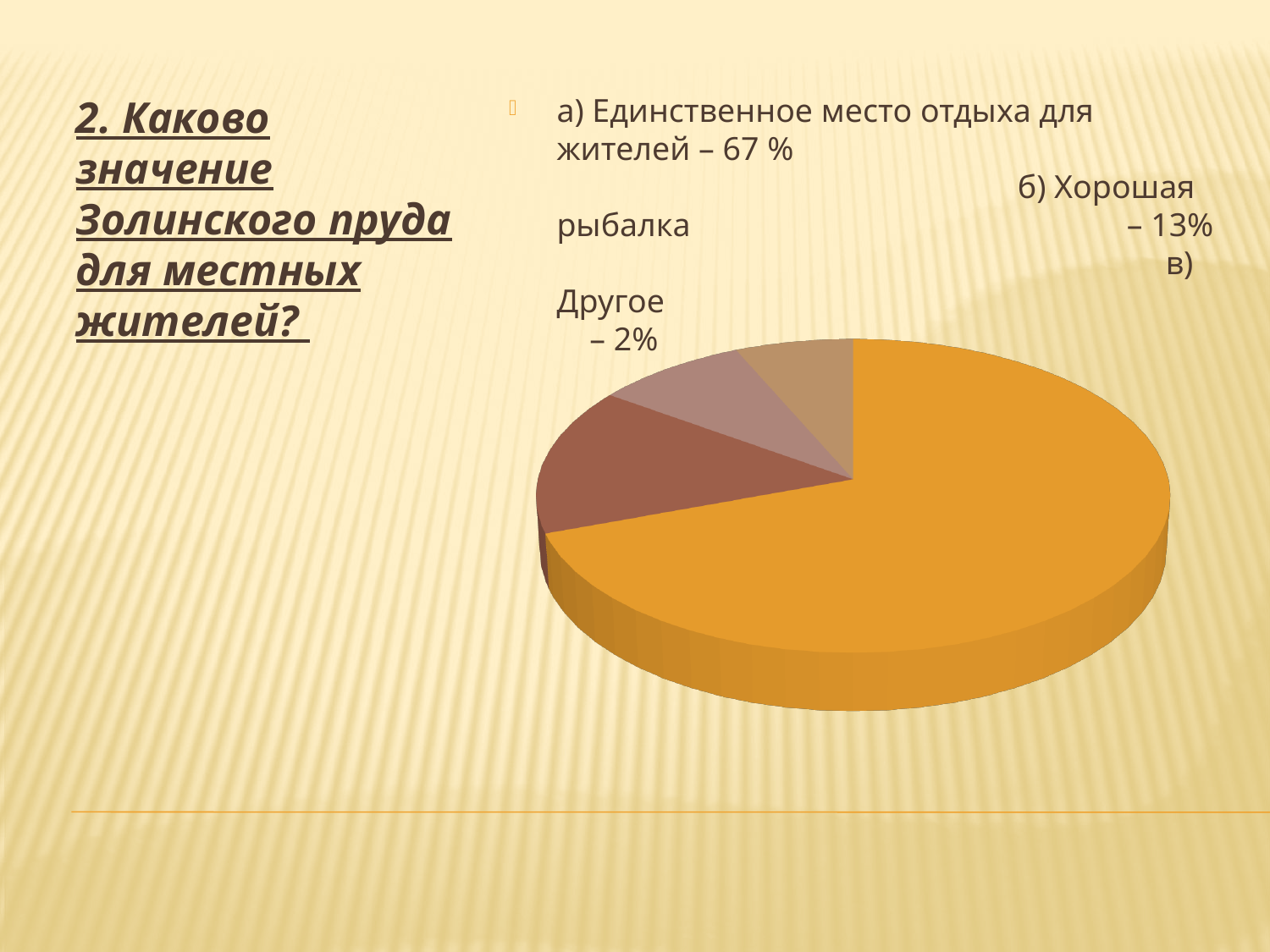
What is the difference in percentage points between 'Хорошая рыбалка' and 'Другое'? 11 What share is given for 'Хорошая рыбалка'? 13% Which listed category has the largest share? Единственное место отдыха для жителей How many slices does the pie chart have? 4 What share is given for 'Единственное место отдыха для жителей'? 67 % What share is given for 'Другое'? 2% Does the largest slice of the pie take up more or less than half of the pie? more What colour is the largest slice of the pie? orange What is the difference in percentage points between 'Единственное место отдыха для жителей' and 'Хорошая рыбалка'? 54 What kind of chart is shown on the slide? pie chart Which listed category has the smallest share? Другое Which is larger, the share for 'Хорошая рыбалка' or for 'Другое'? Хорошая рыбалка